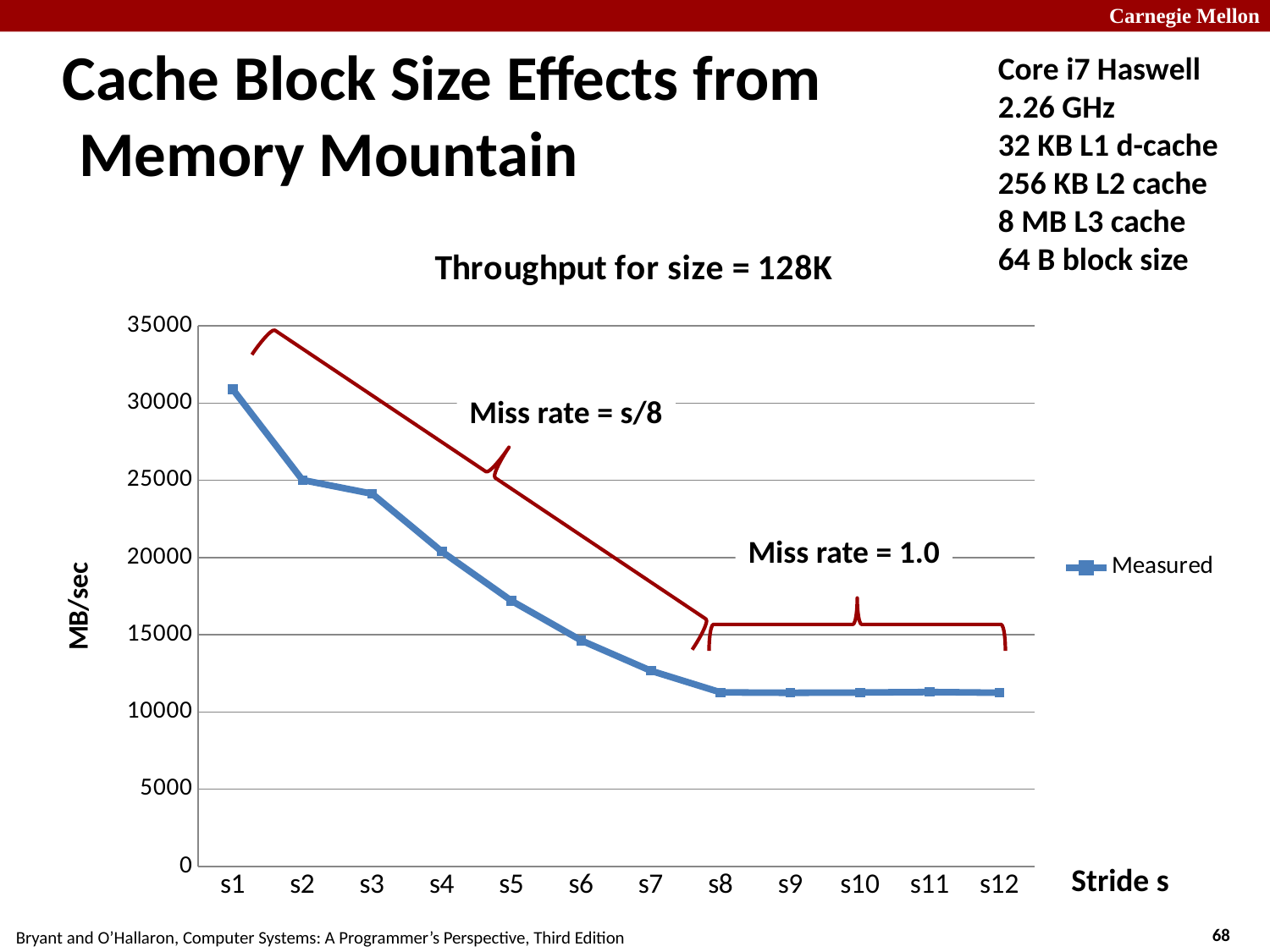
Is the measured throughput for s5 greater or less than 20000 MB/sec? less How many series does the chart legend list? 1 Which stride has the highest measured throughput? s1 Is the measured throughput for s10 greater or less than 10000 MB/sec? greater How many stride values are plotted along the x axis? 12 Is the measured throughput for s1 greater or less than 30000 MB/sec? greater What kind of chart is shown on the slide? line chart Which stride has the larger measured throughput, s4 or s6? s4 Do the measured throughput values rise or fall as the stride increases from s1 to s8? fall What is the title of the chart? Throughput for size = 128K